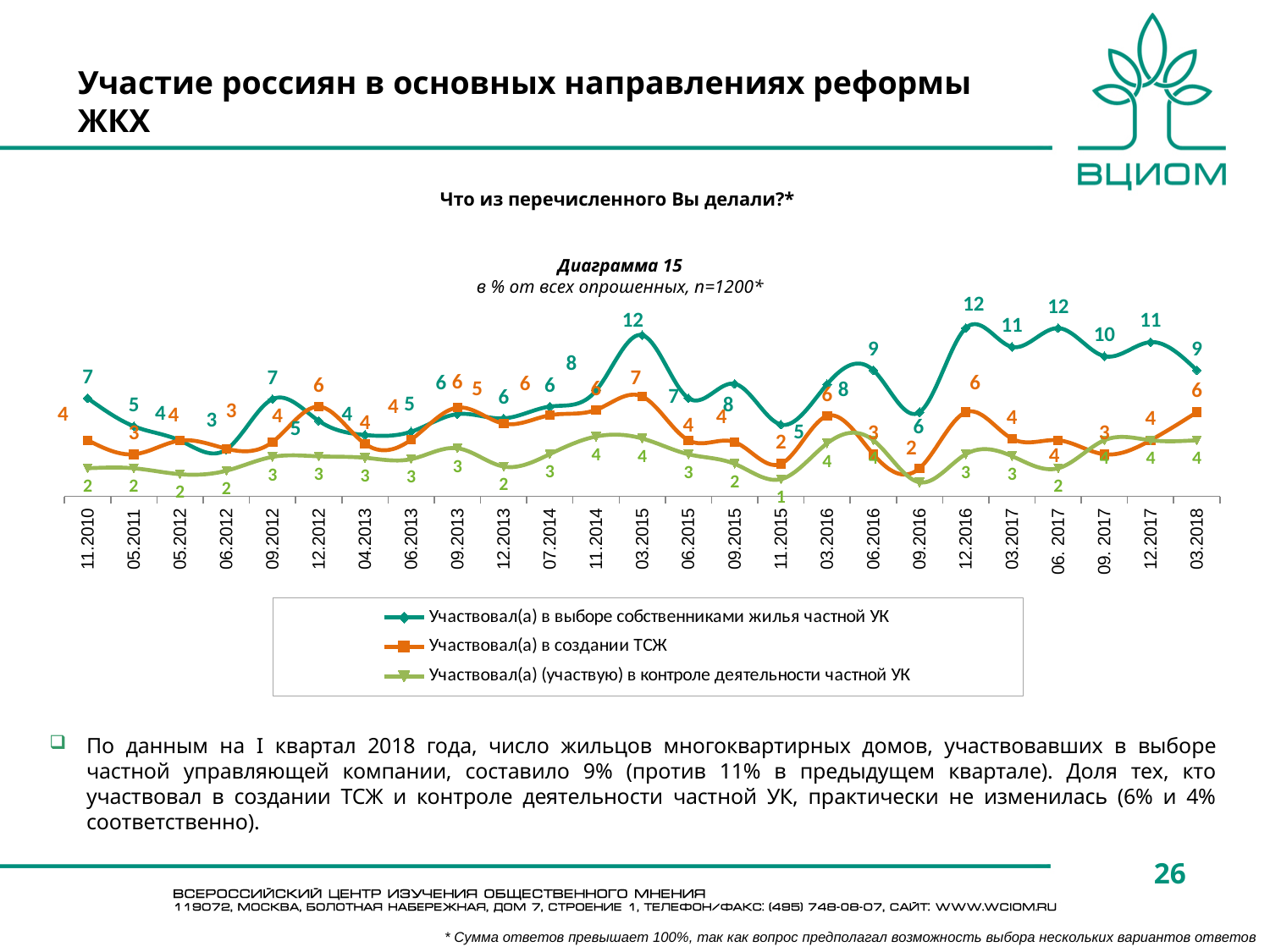
How many series does the legend list? 3 What is the value for 'Участвовал(а) (участвую) в контроле деятельности частной УК' at 03.2018? 4 What is the diagram number given in the chart title? Диаграмма 15 At which time point does 'Участвовал(а) (участвую) в контроле деятельности частной УК' reach its lowest value? 11.2015 and 09.2016 (both 1) What is the value for 'Участвовал(а) в создании ТСЖ' at 03.2015? 7 At which time point does 'Участвовал(а) в создании ТСЖ' reach its highest value? 03.2015 What is the value for 'Участвовал(а) в выборе собственниками жилья частной УК' at 03.2018? 9 What is the value for 'Участвовал(а) в выборе собственниками жилья частной УК' at 11.2010? 7 How many time points are plotted along the x axis? 25 What kind of chart is shown on the slide? Line chart At 03.2018, which series has the larger value: 'Участвовал(а) в выборе собственниками жилья частной УК' or 'Участвовал(а) в создании ТСЖ'? Участвовал(а) в выборе собственниками жилья частной УК By how much did 'Участвовал(а) в выборе собственниками жилья частной УК' change from 12.2017 to 03.2018? Decreased by 2 (from 11 to 9)